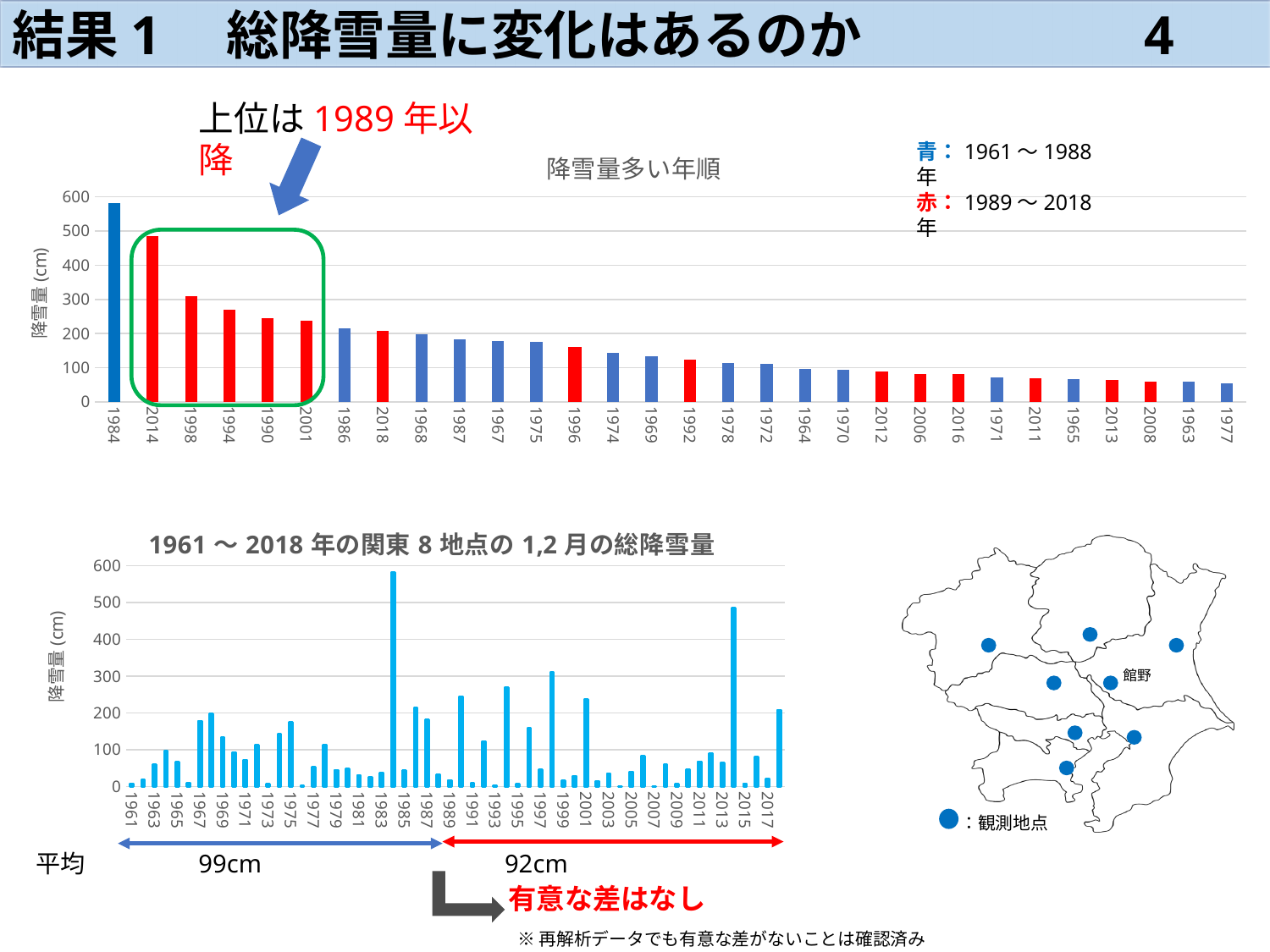
In the top chart (降雪量多い年順), is the value for 1963 greater or less than 100? less In the top chart (降雪量多い年順), is the value for 1994 greater or less than 200? greater How many years (bars) are shown in the top chart (降雪量多い年順)? 30 In the top chart (降雪量多い年順), which is larger, the value for 1998 or the value for 1994? 1998 In the bottom chart (1961～2018年の関東8地点の1,2月の総降雪量), which year has the highest snowfall? 1984 In the top chart (降雪量多い年順), which year has the lowest snowfall? 1977 In the top chart (降雪量多い年順), is the value for 1984 greater or less than 500? greater In the top chart (降雪量多い年順), do the values rise or fall from left to right along the x axis? fall What kind of chart is the top chart titled 降雪量多い年順? bar chart Below the bottom chart, what is the average (平均) snowfall shown for the 1961–1988 period? 99cm In the top chart (降雪量多い年順), which year has the highest snowfall? 1984 In the top chart (降雪量多い年順), which period do the red bars represent? 1989～2018年